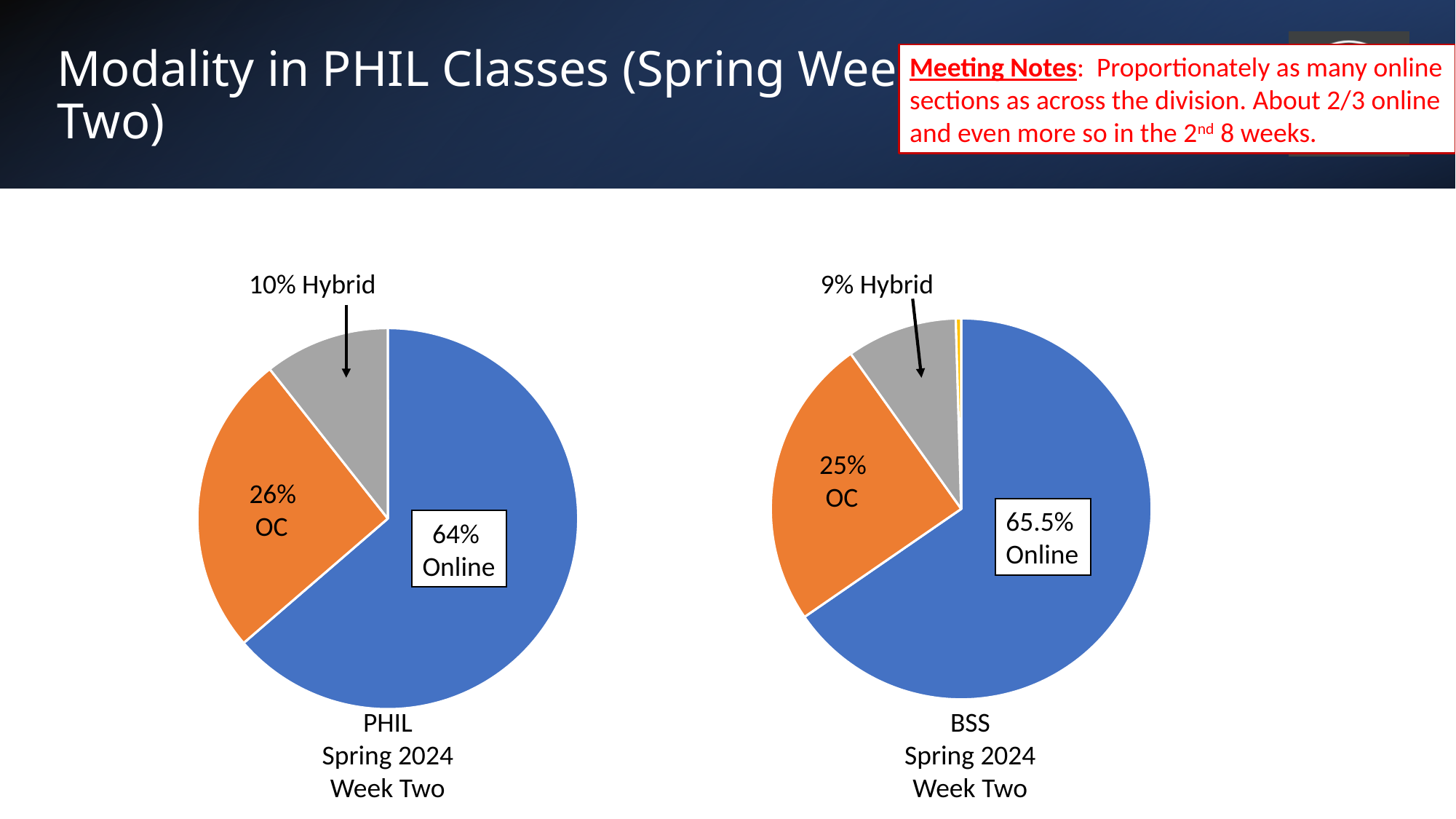
In the PHIL Spring 2024 Week Two chart, how many labeled slices does the pie have? 3 In the PHIL Spring 2024 Week Two pie chart, which modality has the largest slice? Online In the PHIL Spring 2024 Week Two pie chart, what share is OC? 26% In the PHIL Spring 2024 Week Two pie chart, what share of sections is Online? 64% Which chart shows a larger Online share, PHIL Spring 2024 Week Two or BSS Spring 2024 Week Two? BSS Spring 2024 Week Two In the BSS Spring 2024 Week Two pie chart, what colour is the Online slice? Blue In the PHIL Spring 2024 Week Two pie chart, how many percentage points larger is the Online share than the OC share? 38 percentage points In the PHIL Spring 2024 Week Two pie chart, which modality has the smallest slice? Hybrid In the BSS Spring 2024 Week Two pie chart, how many percentage points larger is the Online share than the OC share? 40.5 percentage points In the BSS Spring 2024 Week Two pie chart, what share of sections is Online? 65.5% What type of chart is used for the PHIL Spring 2024 Week Two data? Pie chart In the BSS Spring 2024 Week Two pie chart, what share is Hybrid? 9%